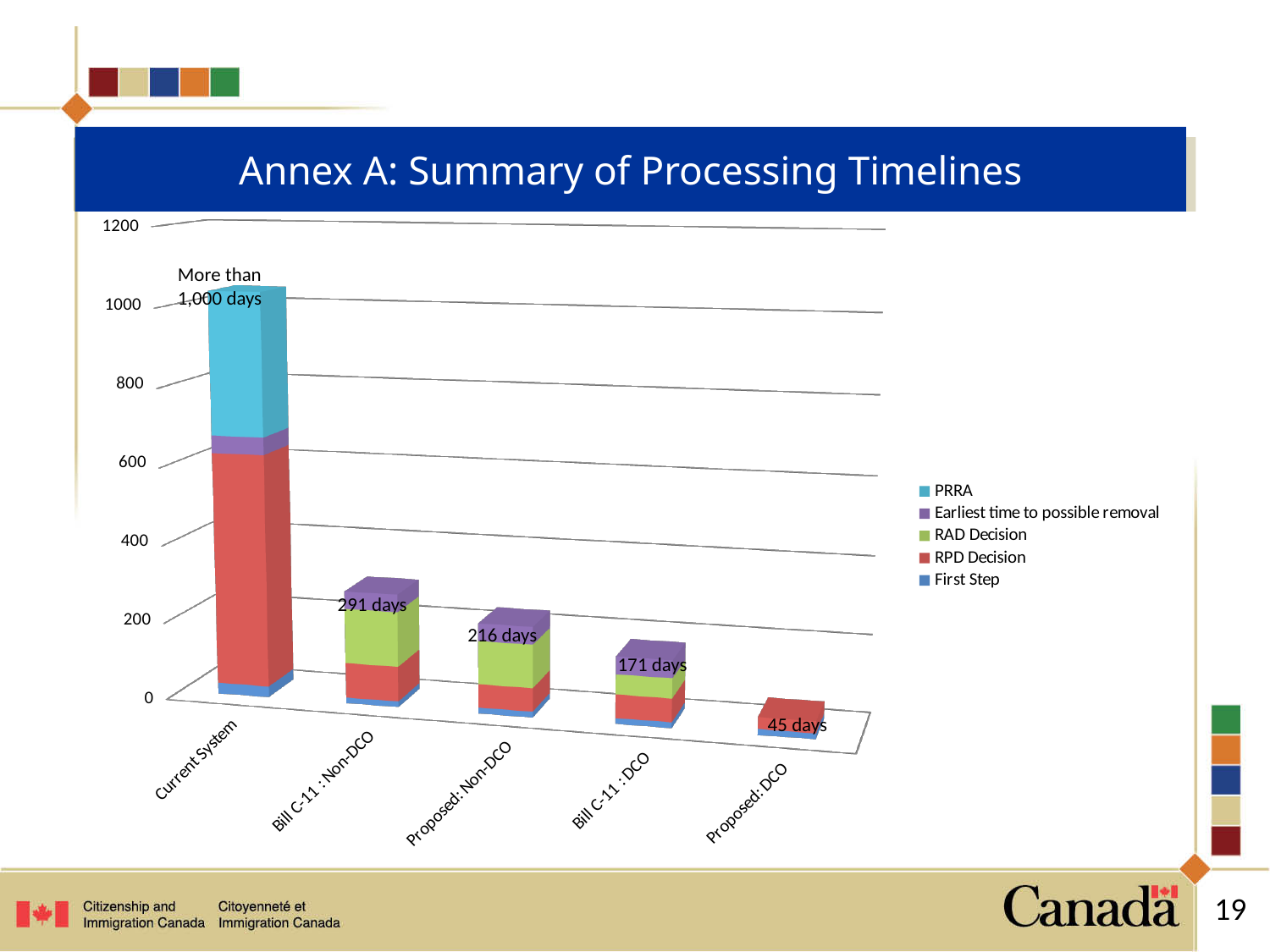
Which is larger, the total for Proposed: Non-DCO or the total for Bill C-11 : DCO? Proposed: Non-DCO What is the total processing time shown for Bill C-11 : Non-DCO? 291 days What is the total processing time shown for Proposed: DCO? 45 days How many days longer is Bill C-11 : DCO than Proposed: DCO? 126 days How many series does the legend list? 5 How many days longer is Bill C-11 : Non-DCO than Proposed: Non-DCO? 75 days Which category has the lowest total processing time? Proposed: DCO Is the value for Current System greater or less than 800? greater What is the total processing time shown for Proposed: Non-DCO? 216 days Which category has the highest total processing time? Current System What kind of chart is shown on the slide? Stacked bar chart What label is shown for the Current System bar? More than 1,000 days